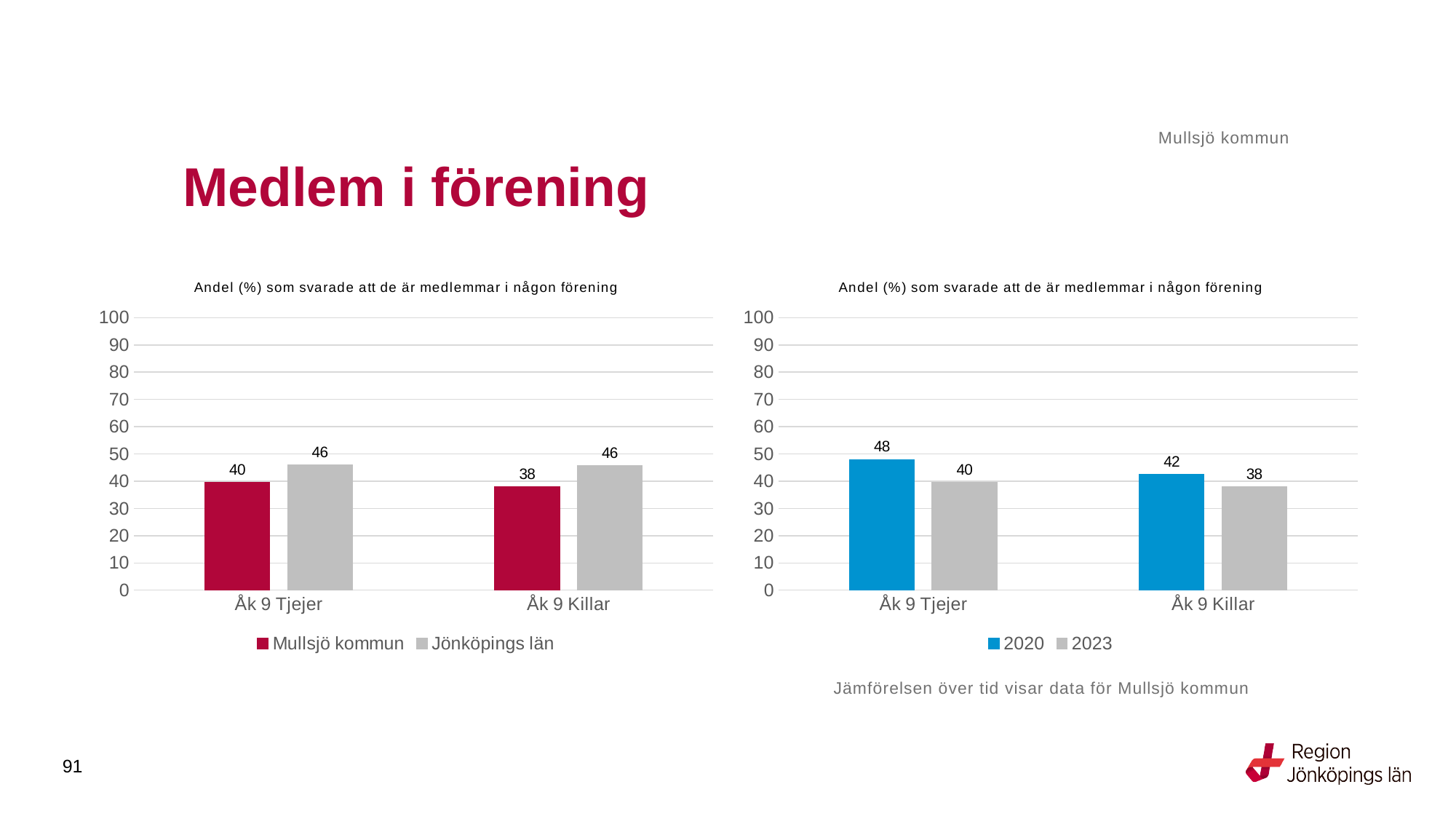
What are the legend entries of the left chart? Mullsjö kommun, Jönköpings län In the right chart, what is the value for 2020 for Åk 9 Tjejer? 48 In the left chart, what is the difference between Jönköpings län and Mullsjö kommun for Åk 9 Killar? 8 In the right chart, is the 2020 value for Åk 9 Tjejer greater or less than 50? less What kind of chart is the left chart? bar chart In the right chart, what is the difference between the 2020 and 2023 values for Åk 9 Tjejer? 8 In the left chart, what is the value for Mullsjö kommun for Åk 9 Tjejer? 40 In the right chart, which is larger for Åk 9 Killar, 2020 or 2023? 2020 In the right chart, what is the value for 2023 for Åk 9 Killar? 38 How many series does the legend of the right chart list? 2 In the left chart, which category has the lowest Mullsjö kommun value? Åk 9 Killar In the left chart, what is the value for Jönköpings län for Åk 9 Killar? 46